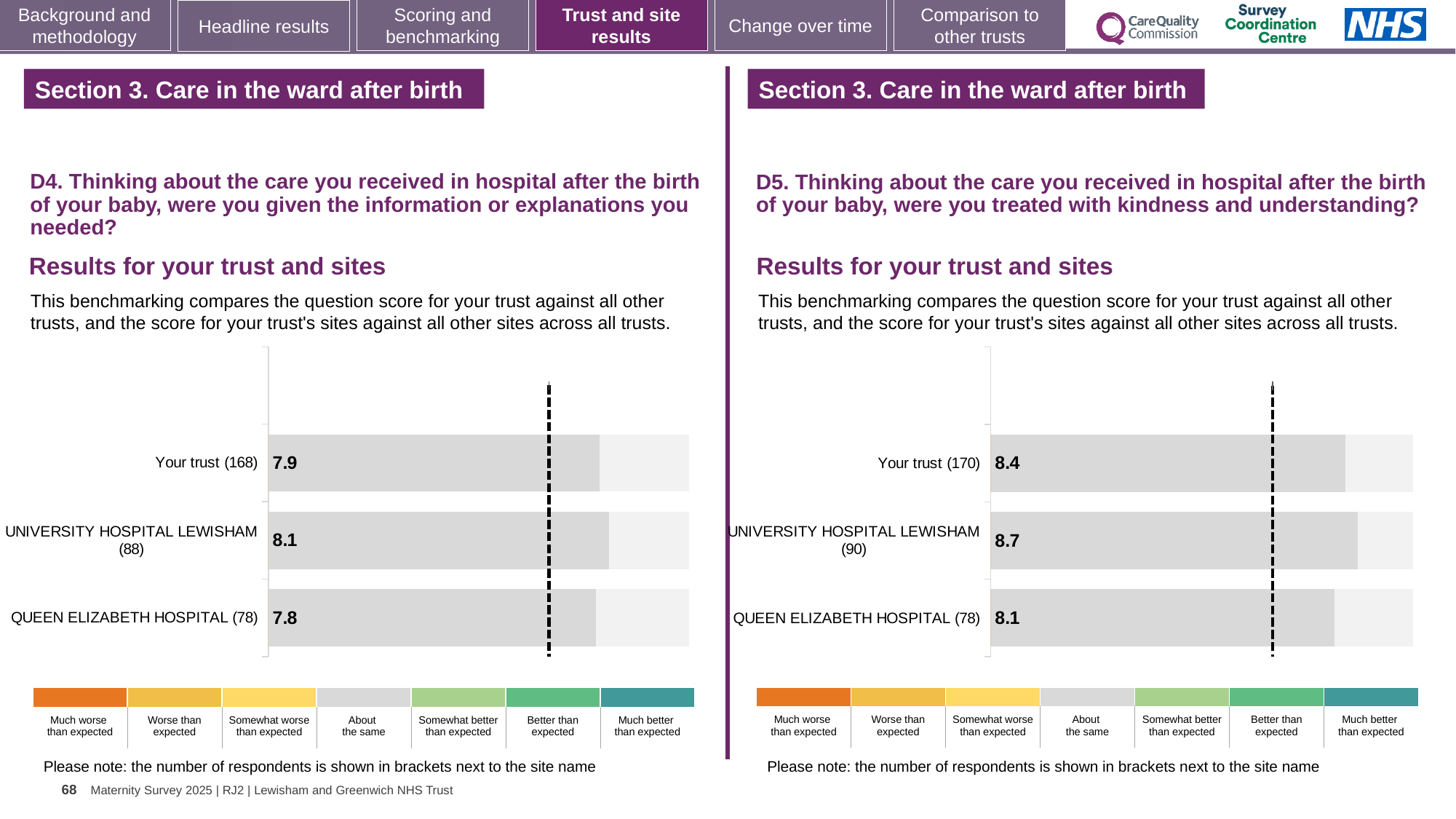
On the left chart (D4), what is the score for UNIVERSITY HOSPITAL LEWISHAM? 8.1 On the left chart (D4), which has the larger score, Your trust or QUEEN ELIZABETH HOSPITAL? Your trust What kind of chart is used on the left (D4)? Bar chart On the left chart (D4), what is the score for QUEEN ELIZABETH HOSPITAL? 7.8 On the left chart (D4), what is the score for Your trust? 7.9 On the right chart (D5), what is the score for Your trust? 8.4 How many bars are shown on the right chart (D5)? 3 On the right chart (D5), which site or trust has the lowest score? QUEEN ELIZABETH HOSPITAL On the right chart (D5), what is the difference between the scores for UNIVERSITY HOSPITAL LEWISHAM and QUEEN ELIZABETH HOSPITAL? 0.6 On the right chart (D5), what is the score for UNIVERSITY HOSPITAL LEWISHAM? 8.7 On the right chart (D5), what is the score for QUEEN ELIZABETH HOSPITAL? 8.1 On the left chart (D4), which site or trust has the highest score? UNIVERSITY HOSPITAL LEWISHAM